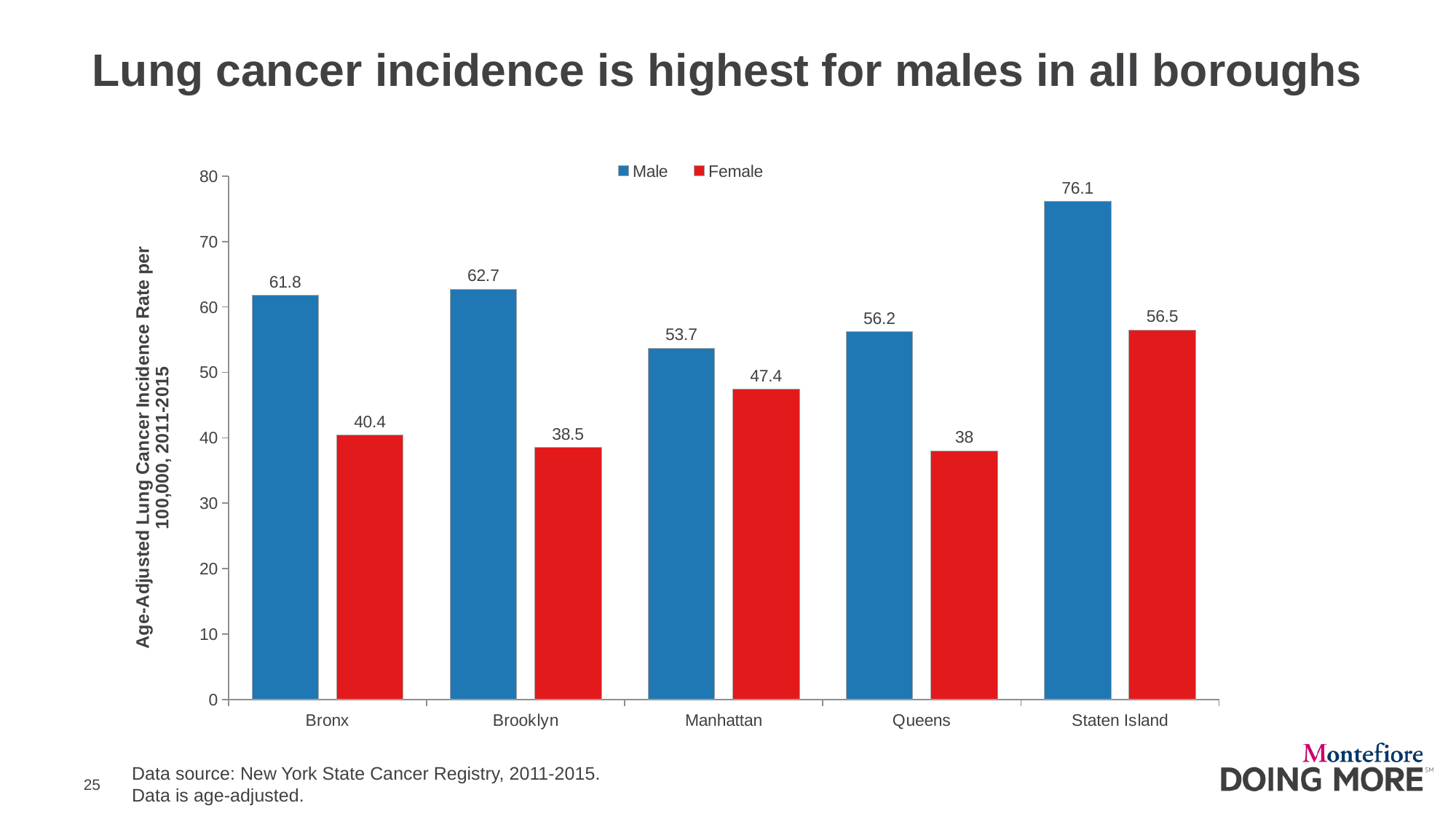
Which borough has the lowest female lung cancer incidence rate? Queens How many series does the legend list? 2 Which borough has the highest male lung cancer incidence rate? Staten Island Which is larger, the female rate in Manhattan or the female rate in Staten Island? Staten Island What is the male lung cancer incidence rate for Staten Island? 76.1 Which borough has the lowest male lung cancer incidence rate? Manhattan What is the difference between the male and female rates in the Bronx? 21.4 How many boroughs are shown on the x axis? 5 What kind of chart is shown on the slide? Bar chart What colour are the Female bars? Red What is the female lung cancer incidence rate for Brooklyn? 38.5 What is the female lung cancer incidence rate for Queens? 38